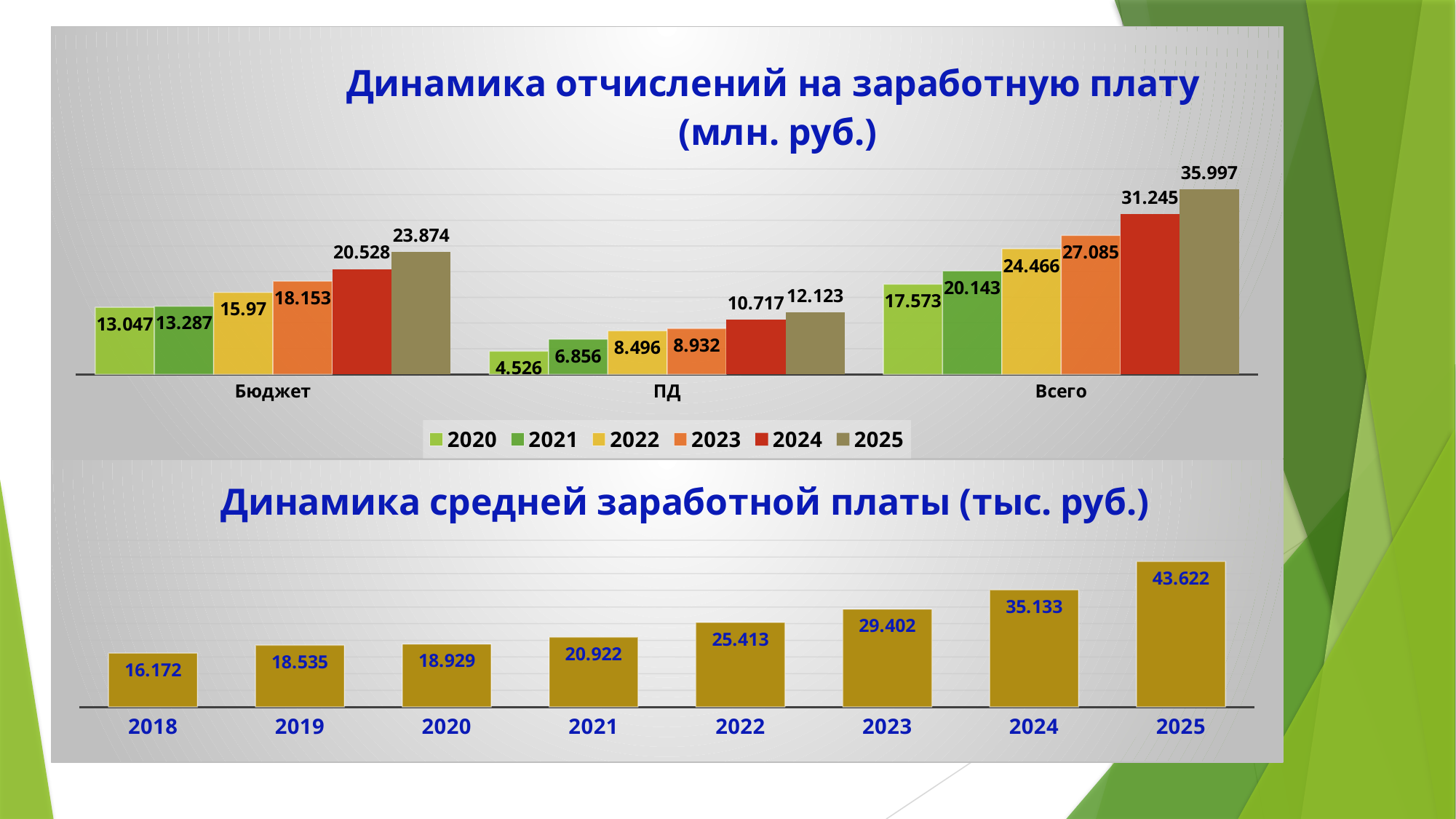
In the bottom chart 'Динамика средней заработной платы (тыс. руб.)', how many years are shown? 8 In the top chart 'Динамика отчислений на заработную плату (млн. руб.)', what is the value for ПД in 2020? 4.526 In the top chart 'Динамика отчислений на заработную плату (млн. руб.)', what is the difference between the Всего values for 2025 and 2024? 4.752 In the top chart 'Динамика отчислений на заработную плату (млн. руб.)', which is larger: Бюджет in 2022 or ПД in 2025? Бюджет in 2022 In the top chart 'Динамика отчислений на заработную плату (млн. руб.)', what is the value for Всего in 2023? 27.085 In the top chart 'Динамика отчислений на заработную плату (млн. руб.)', which category has the highest value in 2024? Всего In the top chart 'Динамика отчислений на заработную плату (млн. руб.)', what is the value for Бюджет in 2025? 23.874 In the top chart 'Динамика отчислений на заработную плату (млн. руб.)', how many series does the legend list? 6 In the bottom chart 'Динамика средней заработной платы (тыс. руб.)', which year has the lowest value? 2018 What kind of chart is the bottom chart 'Динамика средней заработной платы (тыс. руб.)'? bar chart In the bottom chart 'Динамика средней заработной платы (тыс. руб.)', do the values rise or fall from 2018 to 2025? rise In the bottom chart 'Динамика средней заработной платы (тыс. руб.)', what is the value for 2022? 25.413